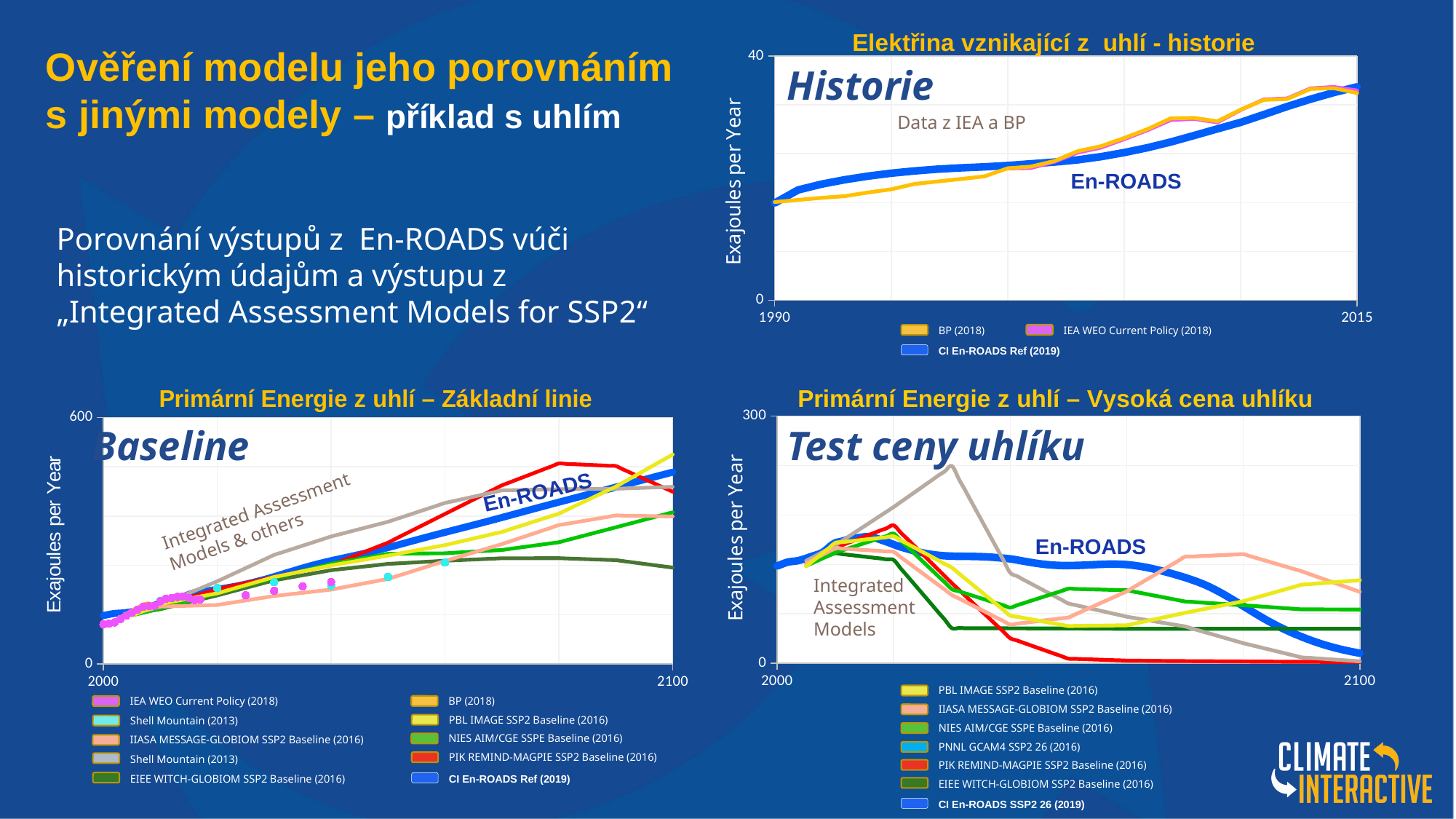
What is the last year shown on the x axis of the 'Elektřina vznikající z uhlí - historie' chart? 2015 What kind of chart is the 'Primární Energie z uhlí – Vysoká cena uhlíku' chart? line chart How many series does the legend of the 'Primární Energie z uhlí – Vysoká cena uhlíku' chart list? 7 In the 'Elektřina vznikající z uhlí - historie' chart, do the values rise or fall from 1990 to 2015? rise In the 'Primární Energie z uhlí – Základní linie' chart, does the CI En-ROADS Ref (2019) line rise or fall from 2000 to 2100? rise In the 'Primární Energie z uhlí – Základní linie' chart, which is higher in 2100: PBL IMAGE SSP2 Baseline (2016) or EIEE WITCH-GLOBIOM SSP2 Baseline (2016)? PBL IMAGE SSP2 Baseline (2016) How many series does the legend of the 'Primární Energie z uhlí – Základní linie' chart list? 10 In the 'Primární Energie z uhlí – Vysoká cena uhlíku' chart, does the CI En-ROADS SSP2 26 (2019) line rise or fall overall from 2000 to 2100? fall What kind of chart is the 'Elektřina vznikající z uhlí - historie' chart? line chart In the 'Primární Energie z uhlí – Základní linie' chart, is the CI En-ROADS Ref (2019) value in 2100 greater or less than 600? less What is the y-axis label of the 'Elektřina vznikající z uhlí - historie' chart? Exajoules per Year How many series does the legend of the 'Elektřina vznikající z uhlí - historie' chart list? 3